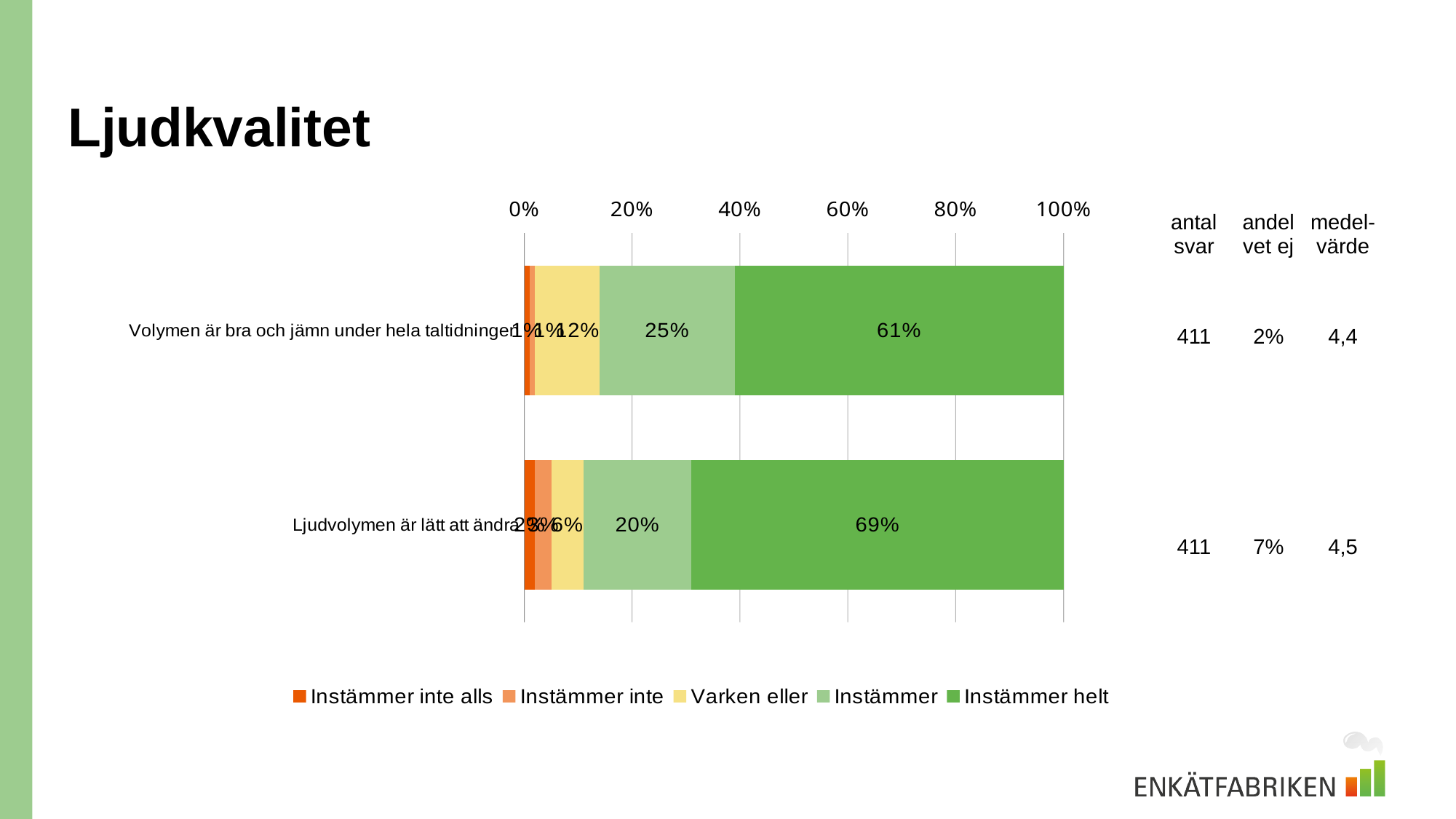
What percentage of respondents answered "Varken eller" for "Volymen är bra och jämn under hela taltidningen"? 12% What is the first entry in the chart legend? Instämmer inte alls What percentage of respondents answered "Instämmer" for "Ljudvolymen är lätt att ändra"? 20% What percentage of respondents answered "Instämmer helt" for "Ljudvolymen är lätt att ändra"? 69% How many response categories does the legend list? 5 How many statements (categories) are shown in the chart? 2 What is the difference in the "Instämmer helt" share between "Ljudvolymen är lätt att ändra" and "Volymen är bra och jämn under hela taltidningen"? 8 percentage points What is the difference in the "Instämmer" share between "Volymen är bra och jämn under hela taltidningen" and "Ljudvolymen är lätt att ändra"? 5 percentage points What type of chart is shown on the slide? Stacked bar chart Which statement has the larger share of "Instämmer helt" responses? Ljudvolymen är lätt att ändra What percentage of respondents answered "Instämmer" for "Volymen är bra och jämn under hela taltidningen"? 25% What percentage of respondents answered "Instämmer helt" for "Volymen är bra och jämn under hela taltidningen"? 61%